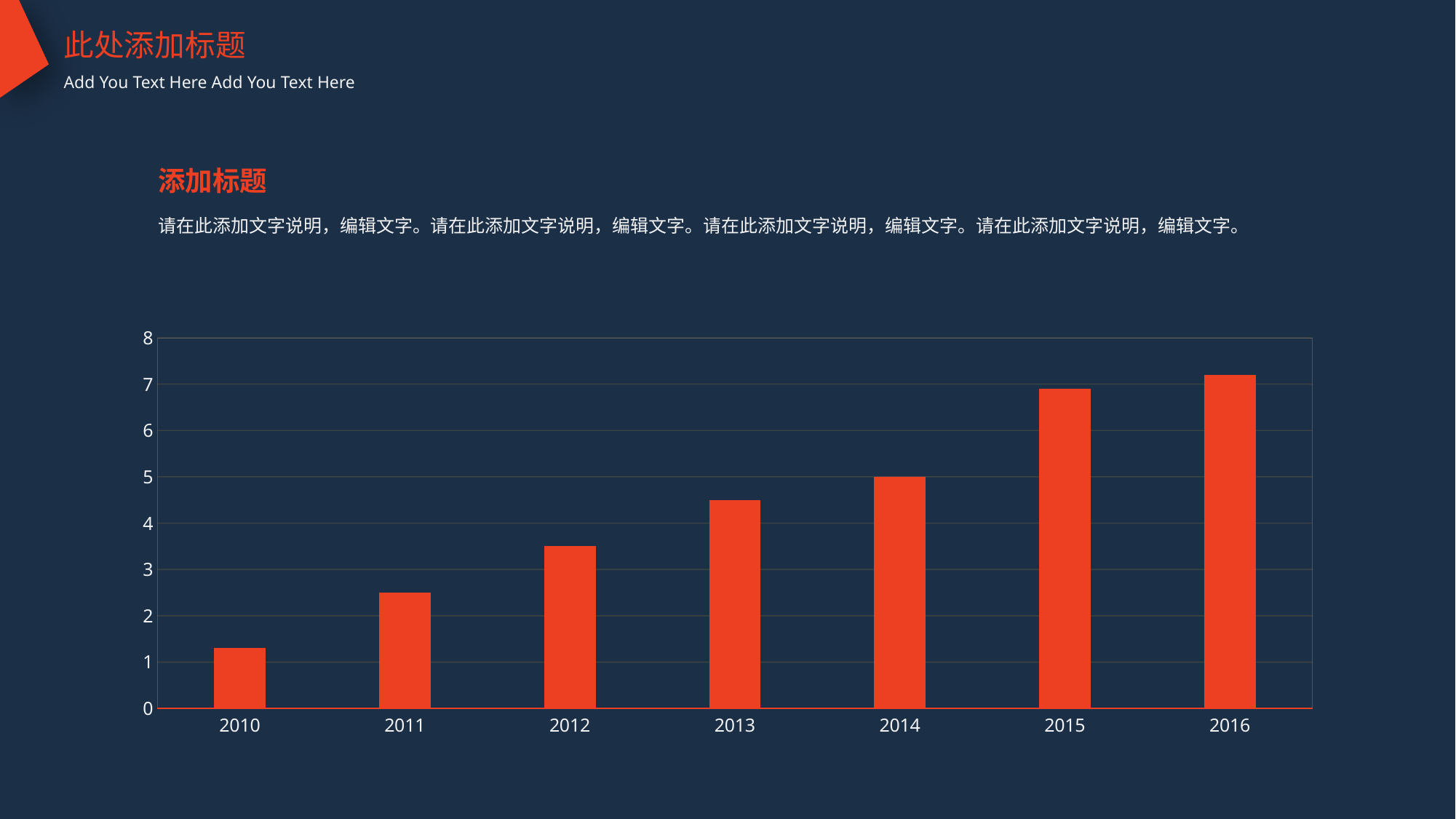
What kind of chart is shown on the slide? bar chart Which year has the lowest bar in the chart? 2010 What is the value for 2014 in the chart? 5 Do the bar values rise or fall from 2010 to 2016? rise Is the value for 2015 greater or less than 6? greater Which year has the highest bar in the chart? 2016 Which is larger, the value for 2011 or the value for 2013? 2013 What is the highest value shown on the y axis of the chart? 8 How many years are shown on the x axis of the chart? 7 Is the value for 2012 greater or less than 3? greater Is the value for 2010 greater or less than 2? less